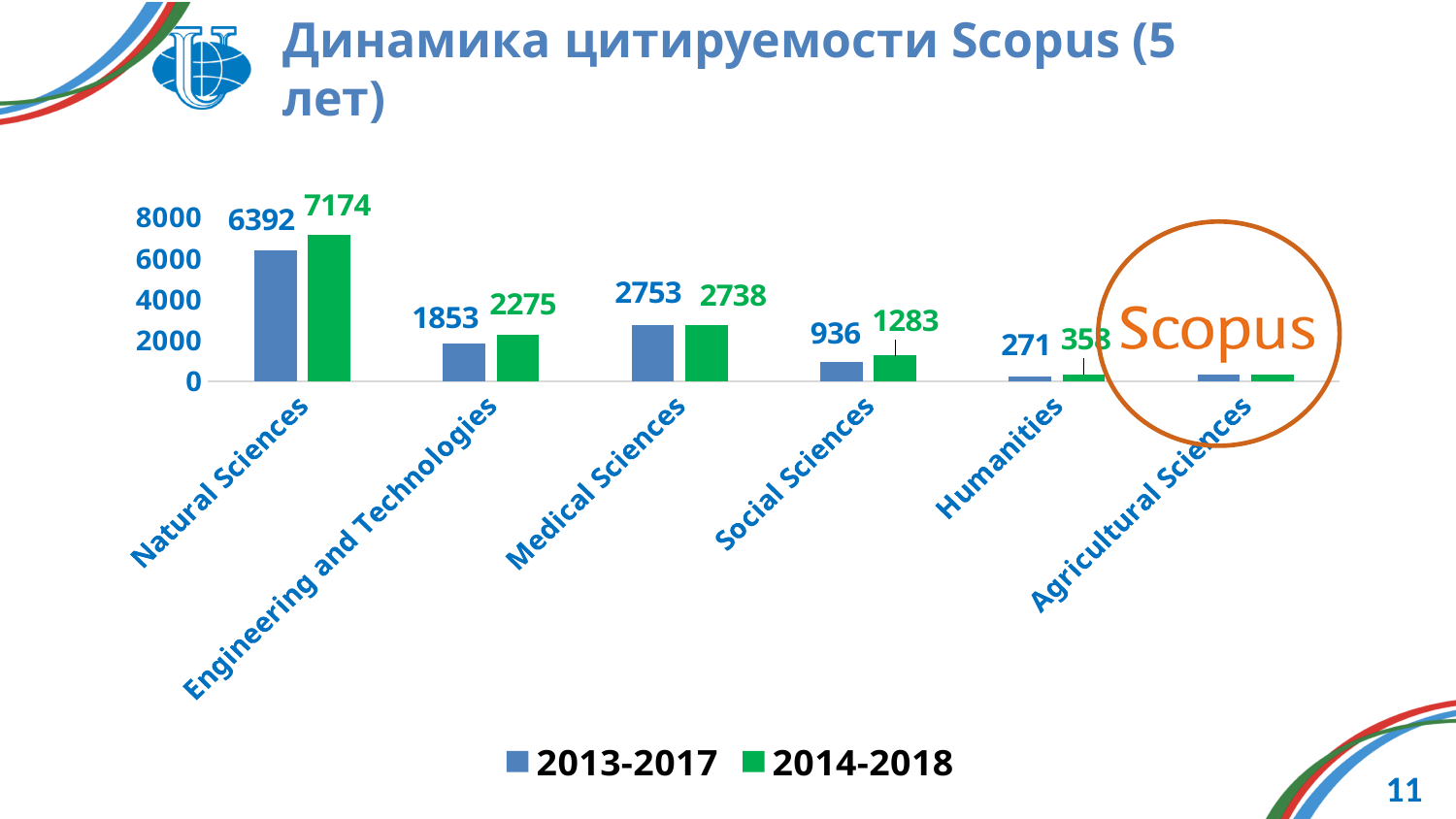
Is the 2013-2017 value for Social Sciences greater or less than 2000? less Which colour represents the 2014-2018 series? green What is the value for Humanities in the 2013-2017 series? 271 What kind of chart is shown on the slide? bar chart Which category has the highest value in the 2013-2017 series? Natural Sciences What is the value for Engineering and Technologies in the 2013-2017 series? 1853 Which is larger for Medical Sciences: the 2013-2017 value or the 2014-2018 value? 2013-2017 How many categories are shown on the x axis? 6 What is the value for Natural Sciences in the 2014-2018 series? 7174 How many series does the legend list? 2 What is the difference between the 2014-2018 and 2013-2017 values for Natural Sciences? 782 What is the value for Social Sciences in the 2014-2018 series? 1283